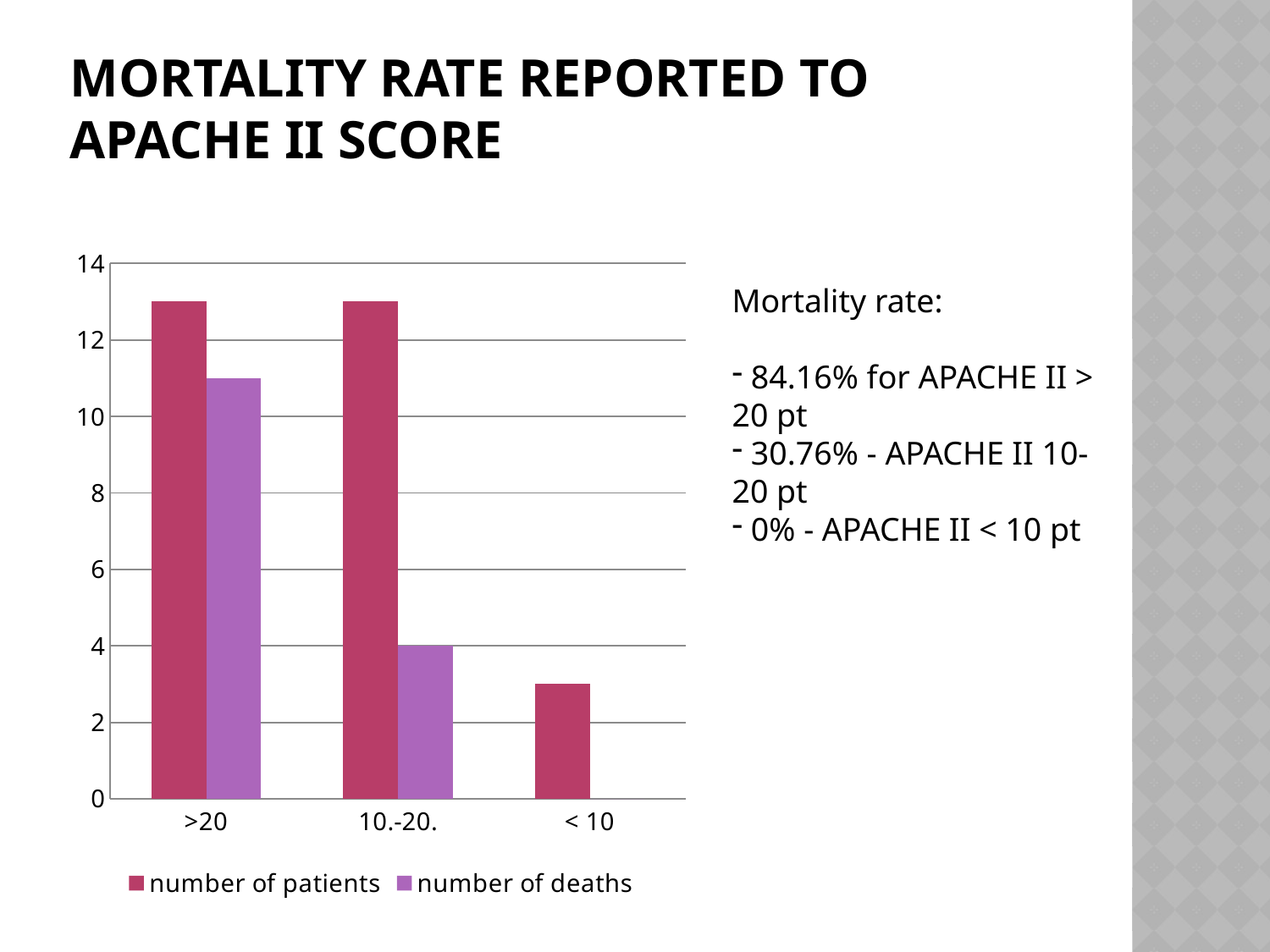
Is the number of patients for the >20 category greater or less than 12? greater How many categories are shown on the x axis? 3 Which category has the highest number of deaths? >20 For the >20 category, which is larger: the number of patients or the number of deaths? number of patients Do the number of deaths values rise or fall moving from left to right along the x axis? fall Which colour represents the number of deaths series in the legend? purple How many series does the legend list? 2 Which category has the lowest number of patients? < 10 Is the number of deaths for the >20 category greater or less than 10? greater What kind of chart is shown on the slide? bar chart Is the number of patients for the < 10 category greater or less than 4? less What is the number of deaths for the 10.-20. category? 4